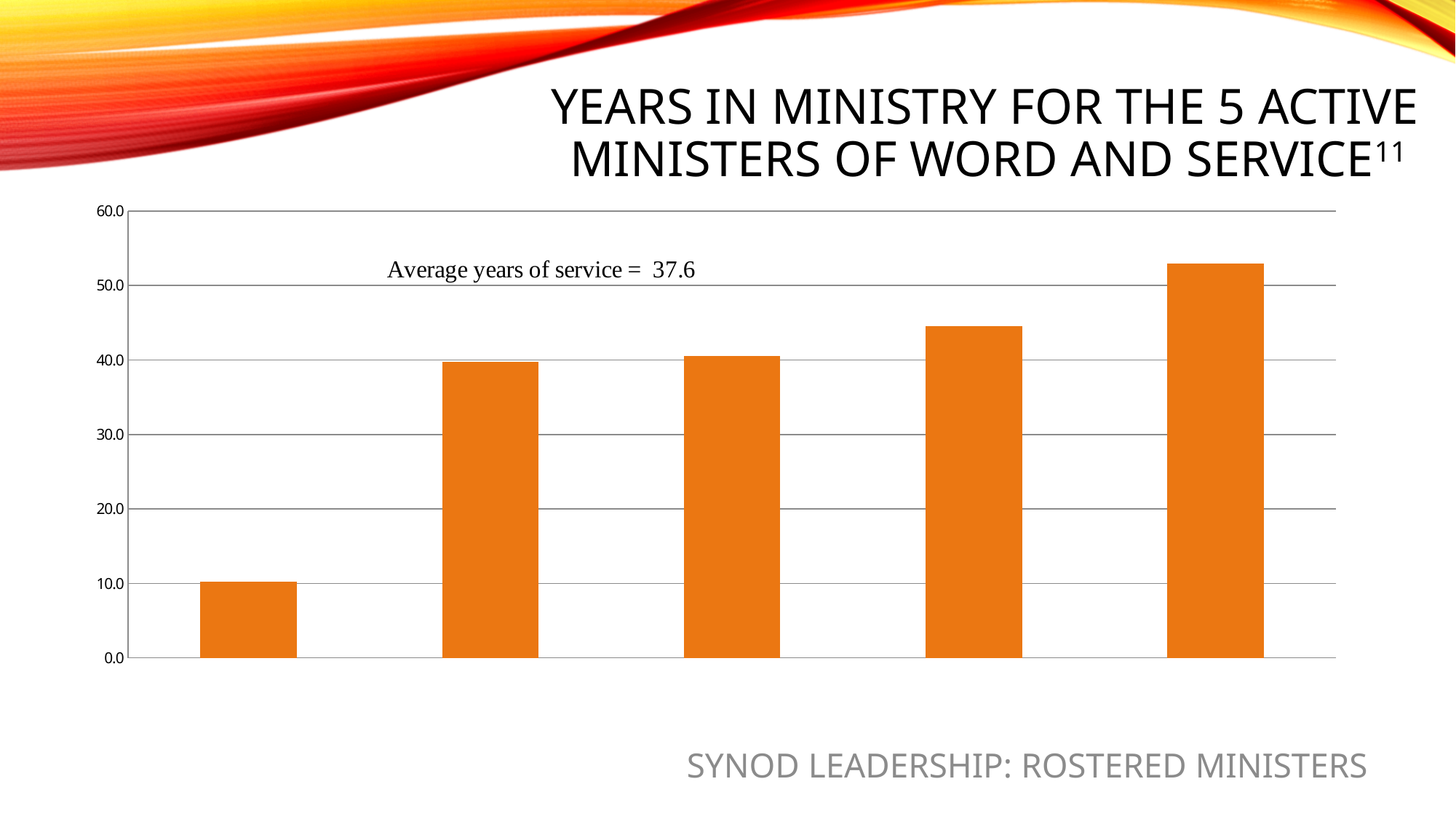
Which is larger, the first bar or the fifth bar? the fifth bar What kind of chart is shown on the slide? bar chart Is the value of the fifth (rightmost) bar greater or less than 50? greater What average years of service is stated on the chart? 37.6 Is the value of the fourth bar greater or less than 40? greater How many bars are plotted in the chart? 5 Is the value of the first (leftmost) bar greater or less than 20? less Which bar is the shortest in the chart? the first (leftmost) bar Which bar is the tallest in the chart? the fifth (rightmost) bar What is the title of the chart on the slide? Years in Ministry for the 5 Active Ministers of Word and Service Do the bar values generally rise or fall from left to right? rise